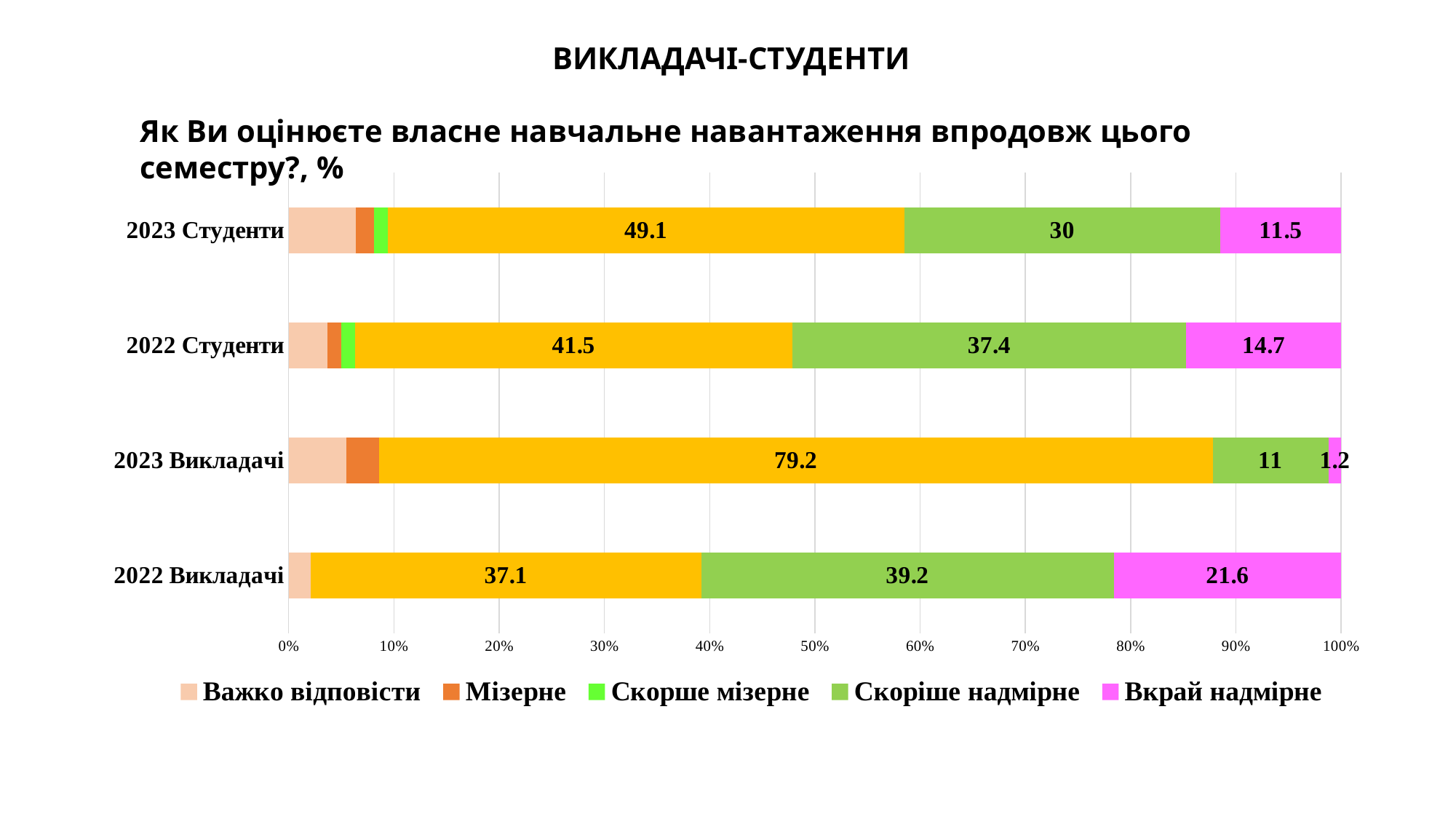
What is the value of "Вкрай надмірне" for 2022 Викладачі? 21.6 What is the value of "Вкрай надмірне" for 2023 Викладачі? 1.2 What kind of chart is shown on the slide? Stacked bar chart How many series does the chart legend list? 5 What value is printed on the largest segment of the 2023 Викладачі bar? 79.2 Which has the larger "Скоріше надмірне" value: 2022 Викладачі or 2022 Студенти? 2022 Викладачі What is the value of "Скоріше надмірне" for 2022 Студенти? 37.4 How many categories (bars) are shown on the y axis of the chart? 4 What is the difference between the "Вкрай надмірне" values for 2022 Студенти and 2023 Студенти? 3.2 Which category has the lowest value for "Скоріше надмірне"? 2023 Викладачі Is the "Важко відповісти" segment for 2023 Викладачі greater or less than 10%? less Which category has the highest value for "Вкрай надмірне"? 2022 Викладачі